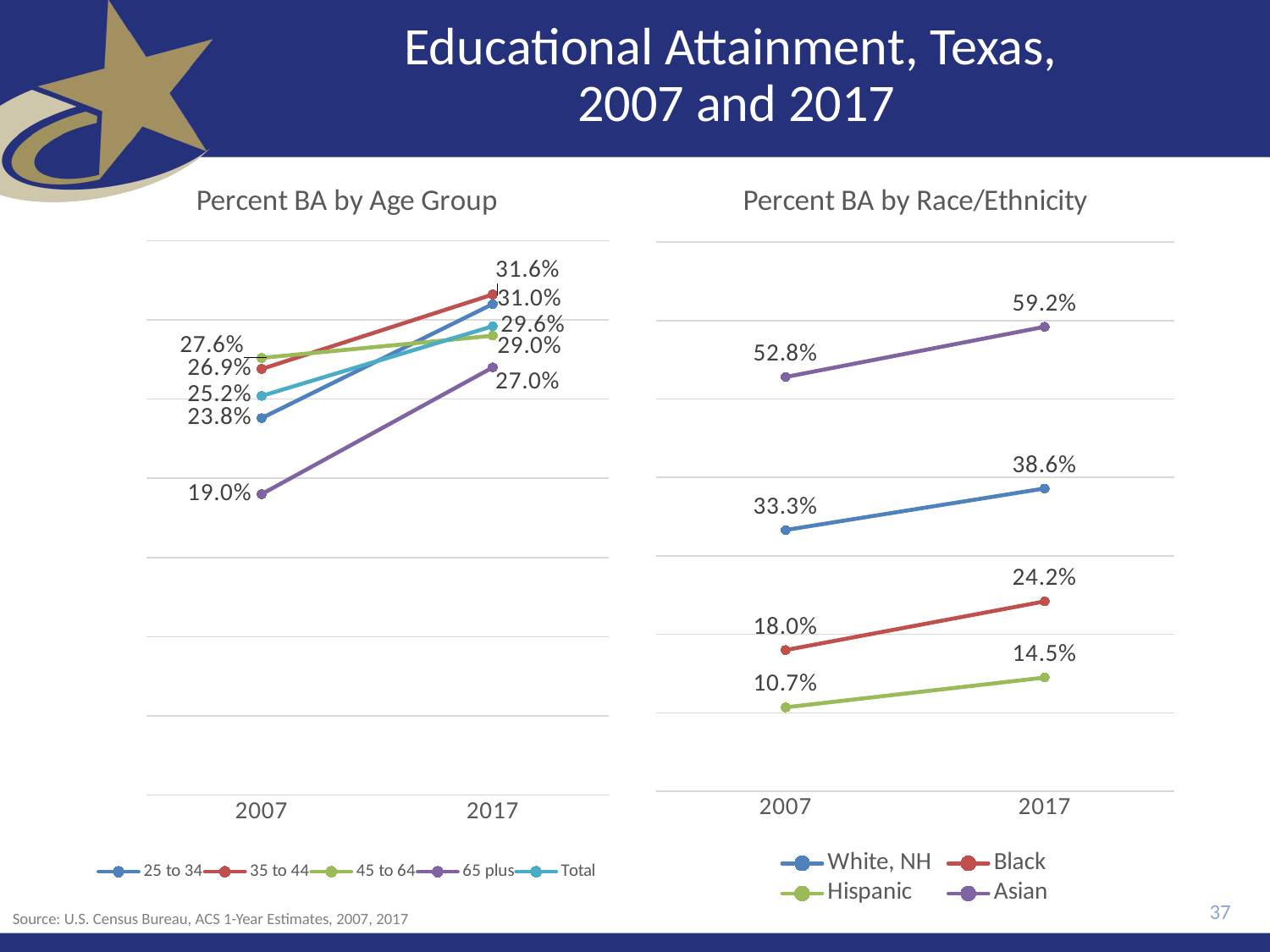
How many series does the legend of the Percent BA by Age Group chart list? 5 What kind of chart is the Percent BA by Age Group chart? line chart In the Percent BA by Age Group chart, does the Total value rise or fall from 2007 to 2017? rise In the Percent BA by Race/Ethnicity chart, what is the difference between the Black values in 2017 and 2007? 6.2% In the Percent BA by Race/Ethnicity chart, what is the value for Asian in 2017? 59.2% How many series does the legend of the Percent BA by Race/Ethnicity chart list? 4 In the Percent BA by Race/Ethnicity chart, is the White, NH value in 2017 larger or smaller than the Black value in 2017? larger In the Percent BA by Race/Ethnicity chart, which group has the lowest value in 2007? Hispanic In the Percent BA by Race/Ethnicity chart, what is the value for Hispanic in 2007? 10.7% In the Percent BA by Age Group chart, which age group has the lowest value in 2017? 65 plus In the Percent BA by Age Group chart, what is the value for 65 plus in 2007? 19.0% In the Percent BA by Race/Ethnicity chart, which group has the highest value in 2017? Asian